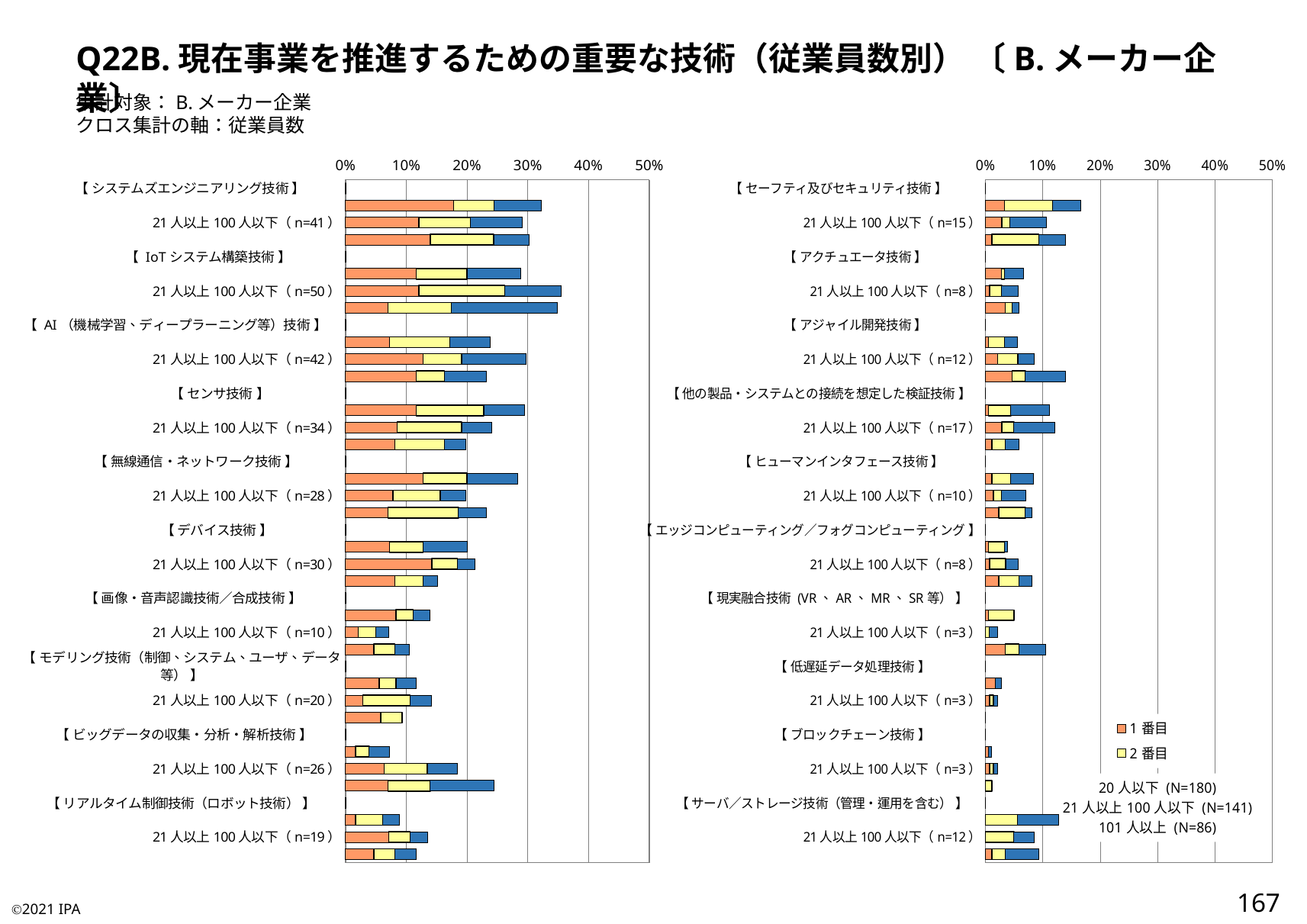
On the right chart, is the total value of the 21人以上100人以下 (n=8) bar under アクチュエータ技術 greater or less than 10%? less On the right chart, is the total value of the 21人以上100人以下 (n=17) bar under 他の製品・システムとの接続を想定した検証技術 greater or less than 10%? greater What kind of chart is the left chart on the slide? stacked bar chart On the left chart, is the total value of the 21人以上100人以下 (n=34) bar under センサ技術 greater or less than 20%? greater What is the maximum value shown on the x axis of the right chart? 50% How many technology categories (bracketed headings) are listed on the left chart? 10 In the legend on the right chart, which colour represents 1番目? orange